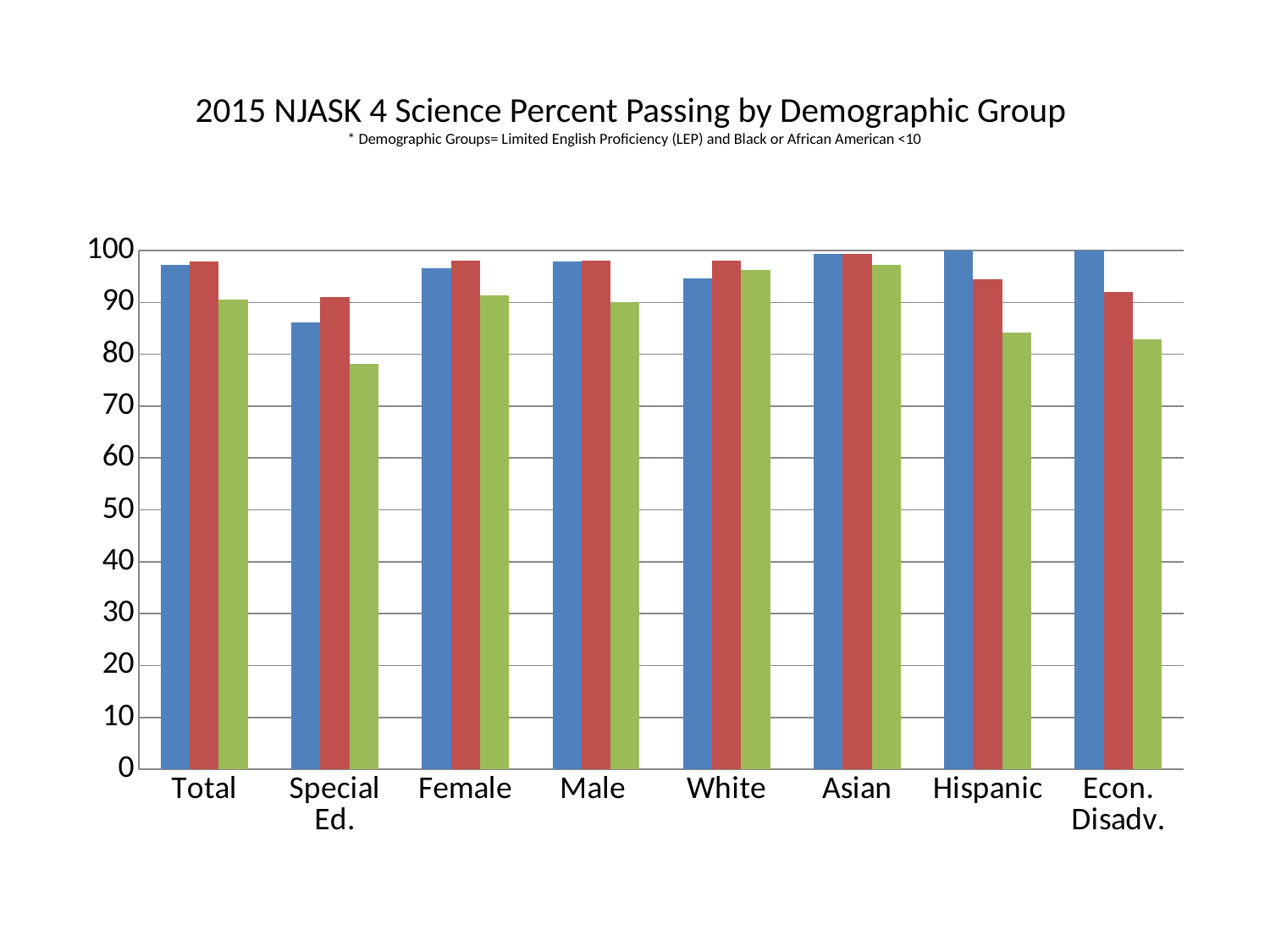
Which group has the lowest blue bar? Special Ed. What is the value of the blue bar for Hispanic? 100 What is the title of the chart? 2015 NJASK 4 Science Percent Passing by Demographic Group Which group has the lowest green bar? Special Ed. What kind of chart is shown on the slide? bar chart Is the value of the green bar for Econ. Disadv. greater or less than 90? less Is the value of the blue bar for Special Ed. greater or less than 90? less Which is larger, the green bar for White or the green bar for Hispanic? White Is the value of the blue bar for Total greater or less than 90? greater How many demographic groups are shown along the x axis? 8 What is the value of the blue bar for Econ. Disadv.? 100